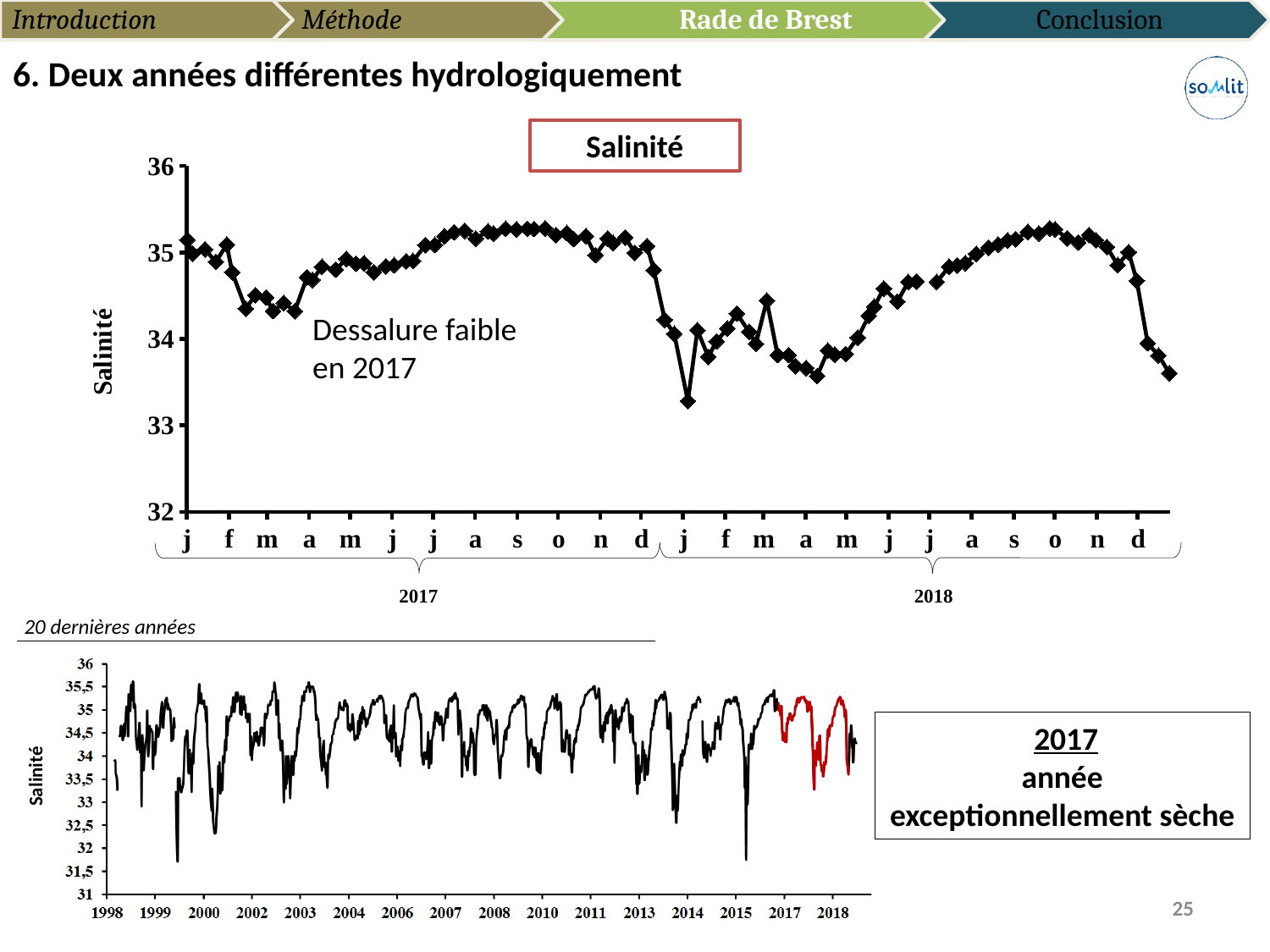
In the top "Salinité" chart, is the lowest value in January 2018 greater or less than 34? less In the top "Salinité" chart, does salinity rise or fall from January 2018 to October 2018? rise In the top "Salinité" chart, does salinity rise or fall from October 2018 to December 2018? fall In the top "Salinité" chart, is the lowest value in March 2017 greater or less than 34? greater What kind of chart is the bottom chart labelled "20 dernières années"? line chart What is the maximum value shown on the y axis of the top "Salinité" chart? 36 What kind of chart is the top chart titled "Salinité"? line chart In the top "Salinité" chart, is the value in September 2017 greater or less than 35? greater In the bottom "20 dernières années" chart, what colour is used to highlight the 2017–2018 period? red In the bottom "20 dernières années" chart, what is the first year shown on the x axis? 1998 In the top "Salinité" chart, which year has the lower minimum salinity, 2017 or 2018? 2018